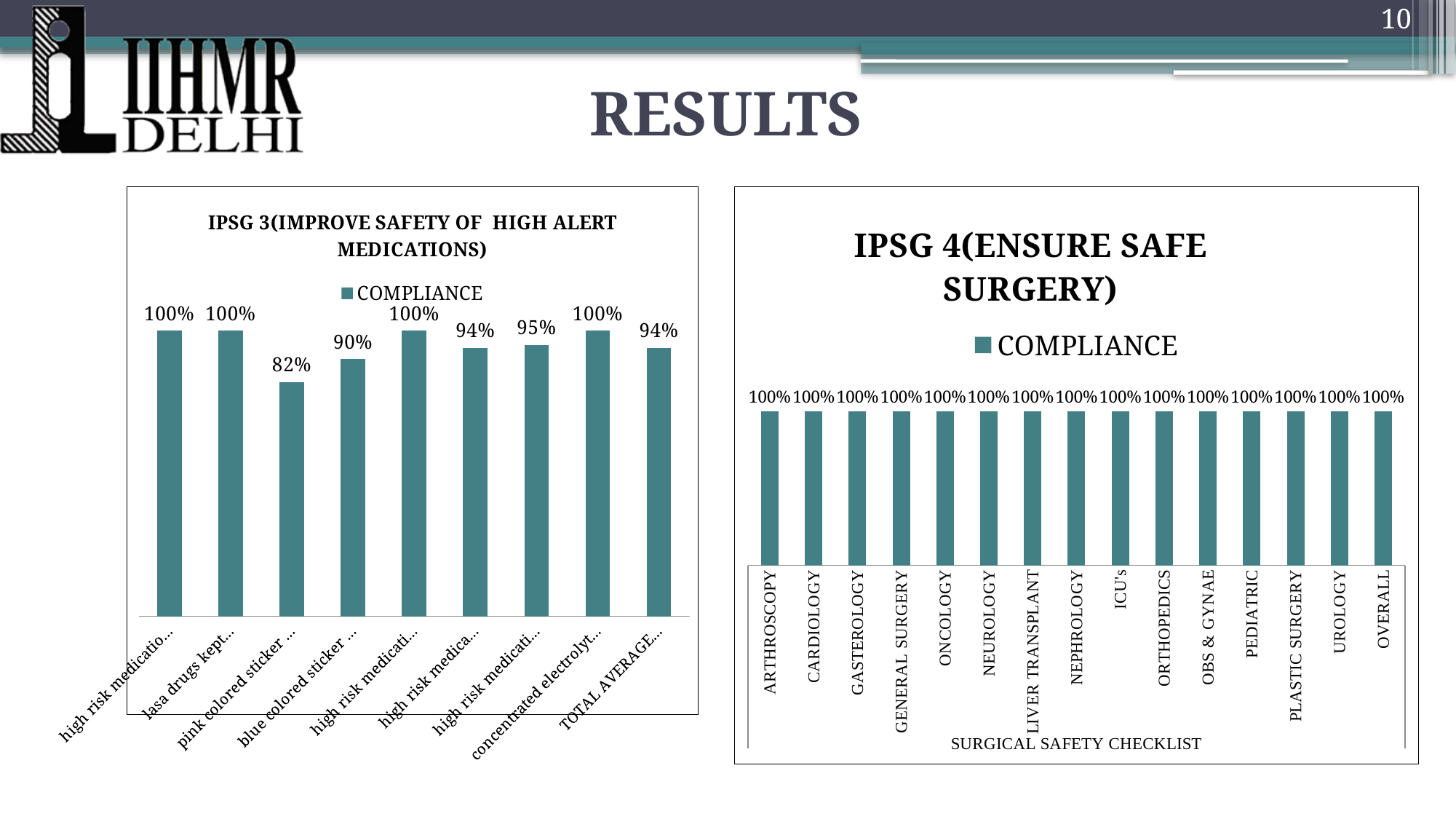
In the IPSG 3 chart on the left, what is the compliance value for the 'blue colored sticker' category? 90% How many series does the legend of the IPSG 4 chart on the right list? 1 In the IPSG 3 chart on the left, which category has the lowest compliance? pink colored sticker In the IPSG 3 chart on the left, what is the difference between the compliance for 'blue colored sticker' and 'pink colored sticker'? 8% In the IPSG 3 chart on the left, which has higher compliance: 'lasa drugs kept' or 'pink colored sticker'? lasa drugs kept In the IPSG 3 chart on the left, what is the compliance value for the 'pink colored sticker' category? 82% How many categories are plotted in the IPSG 4 chart on the right? 15 In the IPSG 4 chart on the right, what is the compliance value for NEPHROLOGY? 100% How many bars are plotted in the IPSG 3 chart on the left? 9 In the IPSG 3 chart on the left, what is the compliance value for the 'TOTAL AVERAGE' category? 94% What kind of chart is the IPSG 4 chart on the right? Bar chart In the IPSG 4 chart on the right, what is the compliance value for OVERALL? 100%